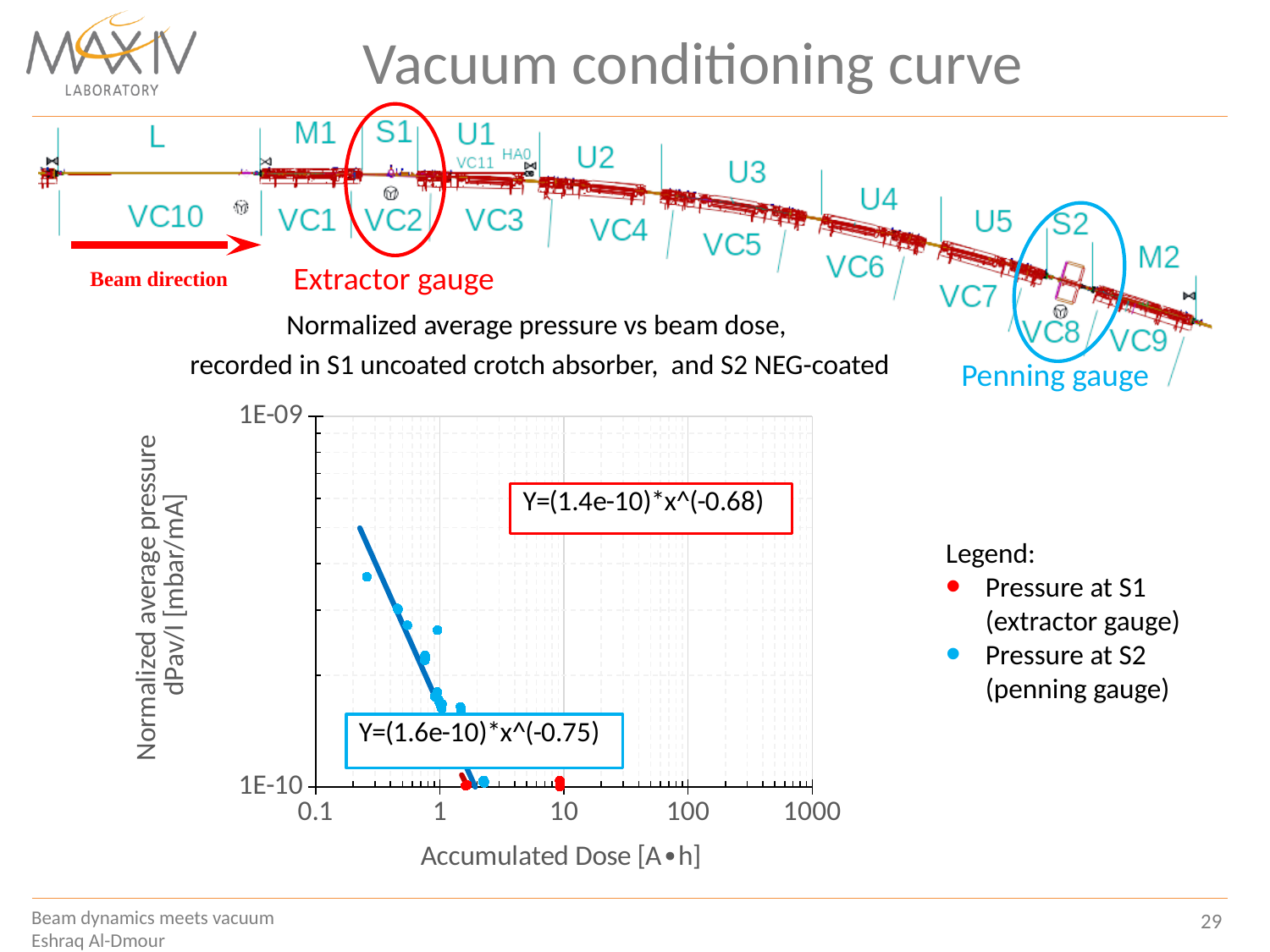
How many series does the legend list? 2 What kind of chart is shown on the slide? scatter chart What fit equation is printed in the blue box for the Pressure at S2 (penning gauge) series? Y=(1.6e-10)*x^(-0.75) What is the highest tick value shown on the x axis? 1000 Is the Pressure at S2 (penning gauge) value at an accumulated dose below 1 A•h greater or less than 1E-10? greater Which series has the larger prefactor in its fit equation, Pressure at S1 (extractor gauge) or Pressure at S2 (penning gauge)? Pressure at S2 (penning gauge) What is the title of the y axis of the chart? Normalized average pressure dPav/I [mbar/mA] What fit equation is printed in the red box for the Pressure at S1 (extractor gauge) series? Y=(1.4e-10)*x^(-0.68) Do the Pressure at S2 (penning gauge) values rise or fall as the accumulated dose increases? fall What is the title of the x axis of the chart? Accumulated Dose [A•h] What is the lowest tick value shown on the y axis? 1E-10 Which series has the fit with the larger magnitude exponent, Pressure at S1 (extractor gauge) or Pressure at S2 (penning gauge)? Pressure at S2 (penning gauge)